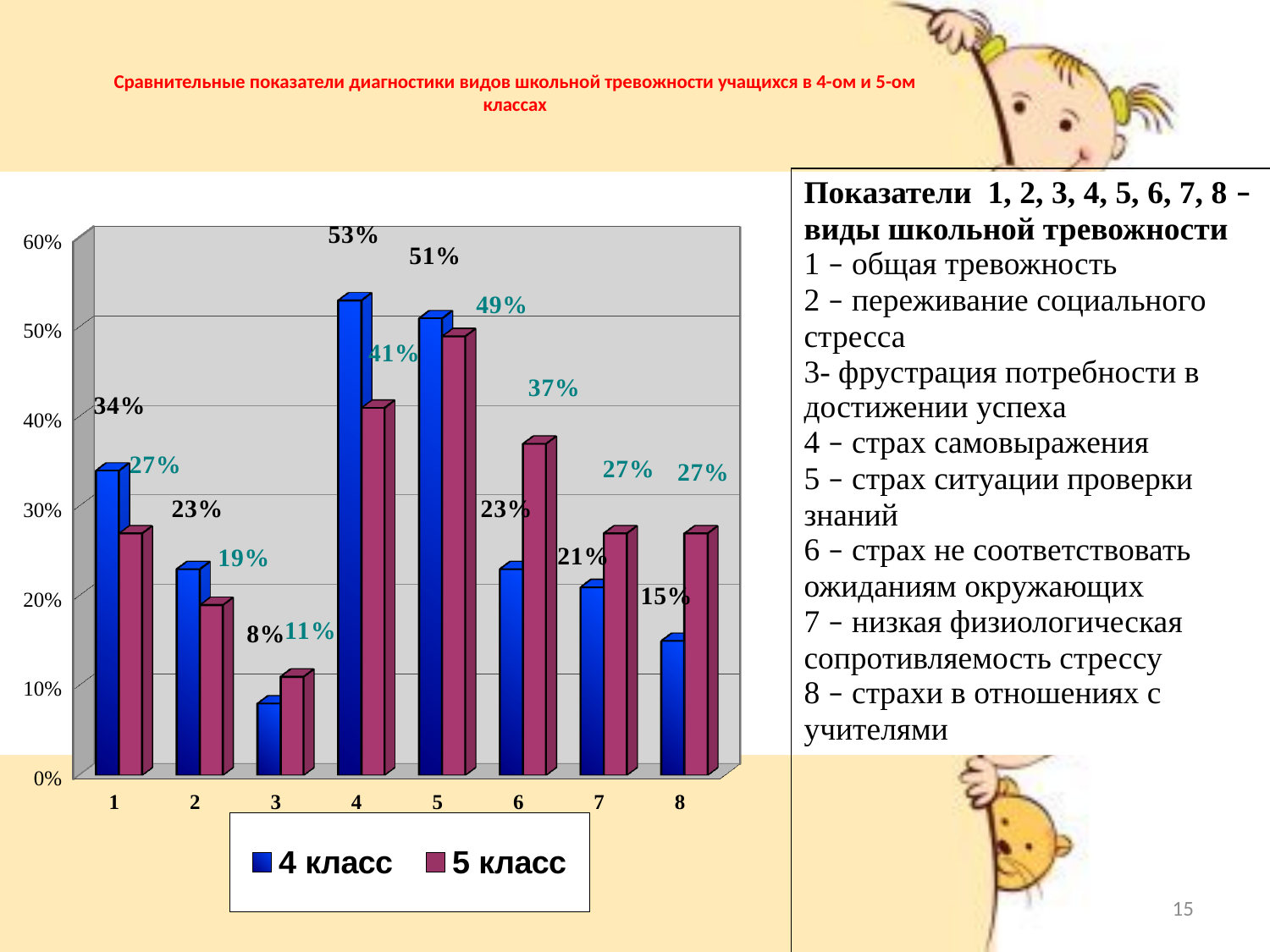
What kind of chart is shown on the slide? bar chart How many series does the legend list? 2 Which is larger for category 8: the 4 класс value or the 5 класс value? 5 класс What is the difference between the 4 класс and 5 класс values for category 4? 12% What is the value for category 6 in the 5 класс series? 37% What is the difference between the 4 класс and 5 класс values for category 6? 14% How many categories are shown on the x axis? 8 Which category has the lowest value in the 4 класс series? 3 What is the value for category 3 in the 4 класс series? 8% Which colour represents the 5 класс series in the legend? magenta What is the value for category 4 in the 4 класс series? 53% Which category has the highest value in the 5 класс series? 5